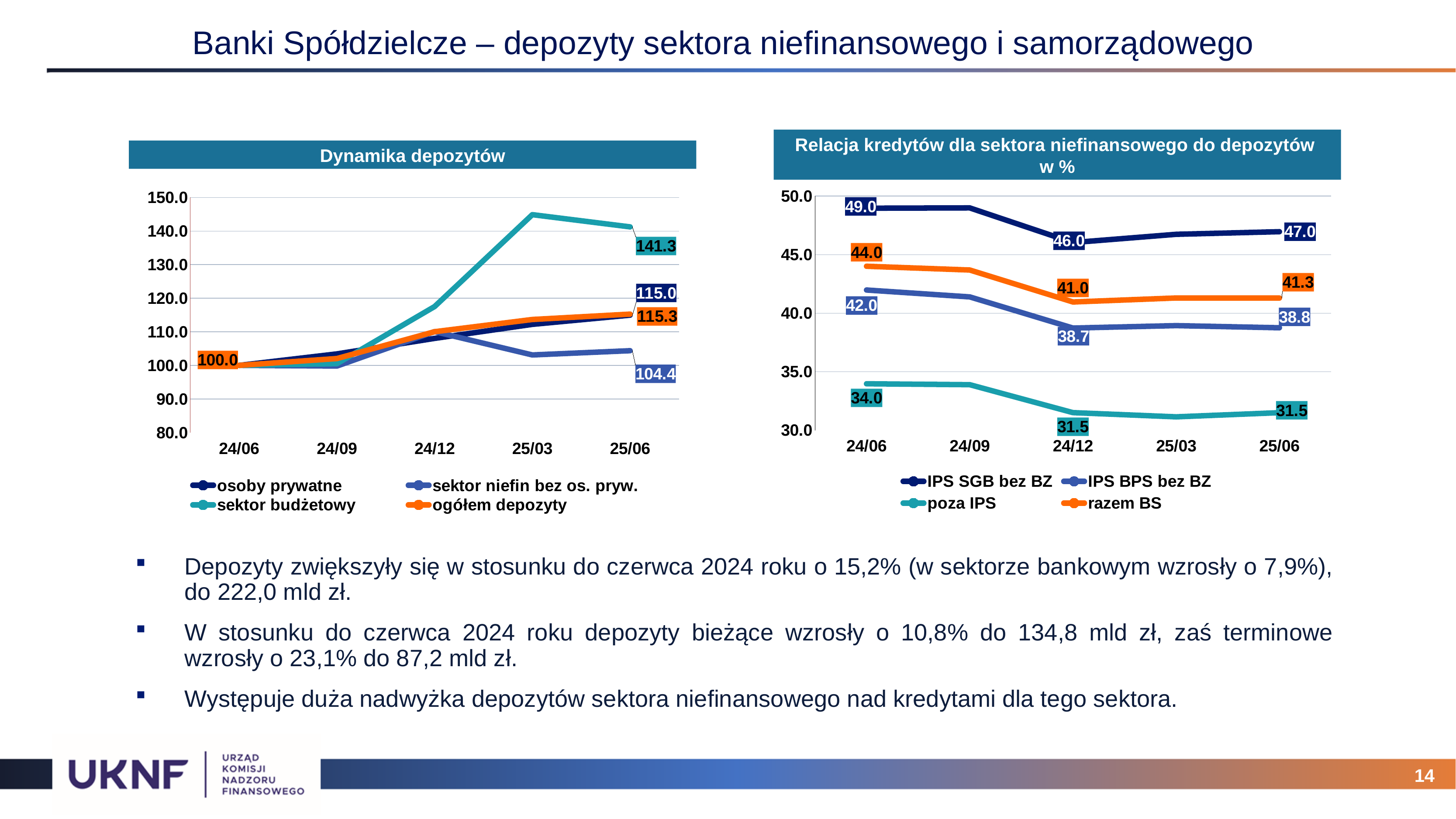
In the chart 'Dynamika depozytów', which is larger at 25/06: ogółem depozyty or sektor niefin bez os. pryw.? ogółem depozyty In the chart 'Relacja kredytów dla sektora niefinansowego do depozytów w %', what is the difference between razem BS at 24/06 and at 24/12? 3.0 How many series does the legend of the chart 'Relacja kredytów dla sektora niefinansowego do depozytów w %' list? 4 What kind of chart is 'Dynamika depozytów'? line chart How many time points are shown on the x axis of the chart 'Dynamika depozytów'? 5 In the chart 'Relacja kredytów dla sektora niefinansowego do depozytów w %', by how much did the value for IPS SGB bez BZ fall from 24/06 to 25/06? 2.0 In the chart 'Dynamika depozytów', which series has the highest value at 25/06? sektor budżetowy In the chart 'Relacja kredytów dla sektora niefinansowego do depozytów w %', which series has the lowest value at 24/12? poza IPS In the chart 'Dynamika depozytów', what is the value for sektor budżetowy at 25/06? 141.3 In the chart 'Dynamika depozytów', is the value for sektor budżetowy at 25/03 greater or less than 140.0? greater In the chart 'Relacja kredytów dla sektora niefinansowego do depozytów w %', what is the value for poza IPS at 25/06? 31.5 In the chart 'Relacja kredytów dla sektora niefinansowego do depozytów w %', what is the value for IPS SGB bez BZ at 24/06? 49.0